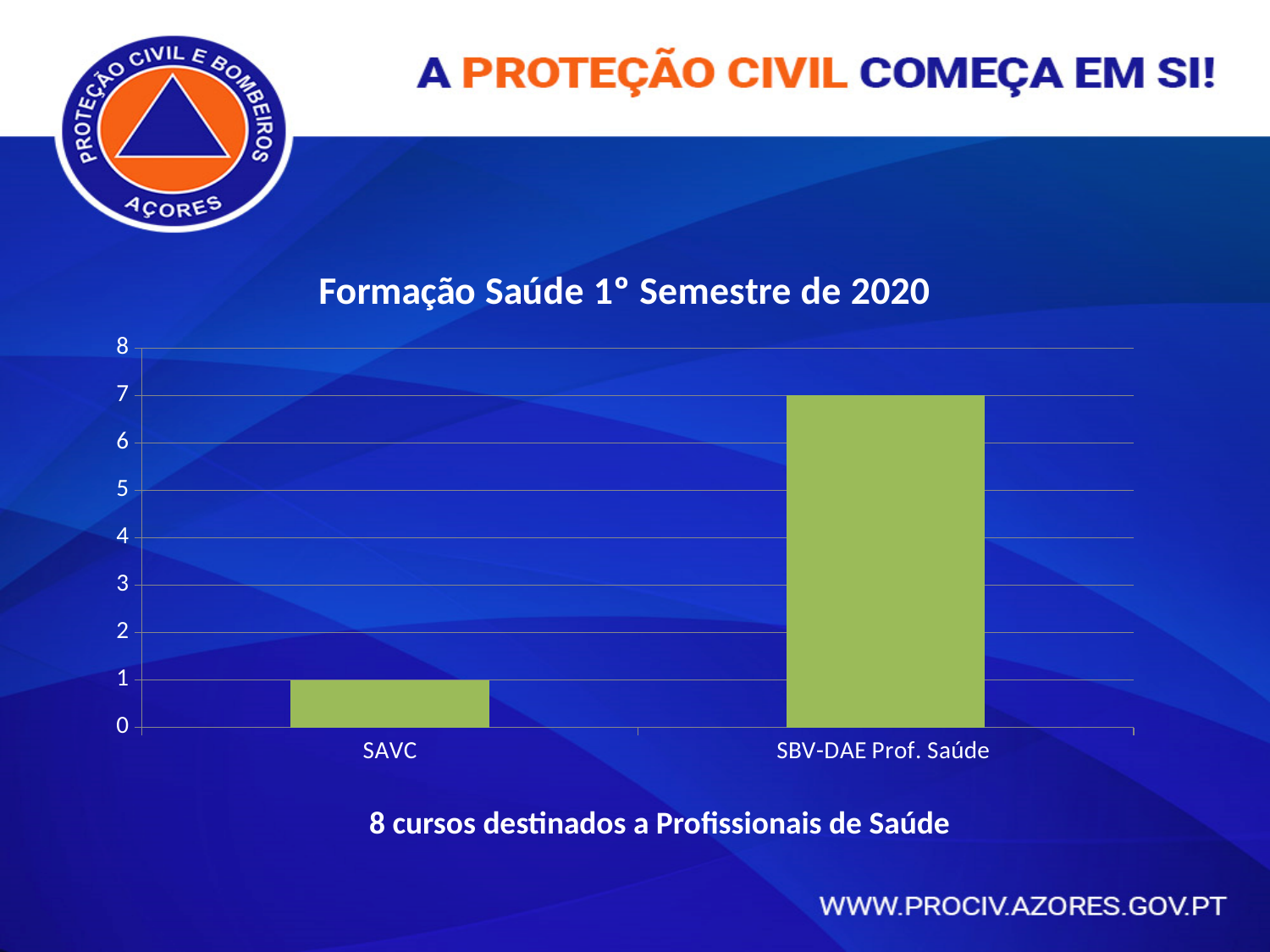
Which category has the lowest value? SAVC Which is larger, the value for SAVC or the value for SBV-DAE Prof. Saúde? SBV-DAE Prof. Saúde How many categories are shown on the x axis? 2 Which category has the highest value? SBV-DAE Prof. Saúde Is the value for SAVC greater or less than 4? less What is the title of the chart? Formação Saúde 1° Semestre de 2020 What kind of chart is shown on the slide? bar chart What is the value for SAVC? 1 Is the value for SBV-DAE Prof. Saúde greater or less than 5? greater What is the highest value shown on the vertical axis? 8 What is the difference between the values for SBV-DAE Prof. Saúde and SAVC? 6 What is the value for SBV-DAE Prof. Saúde? 7